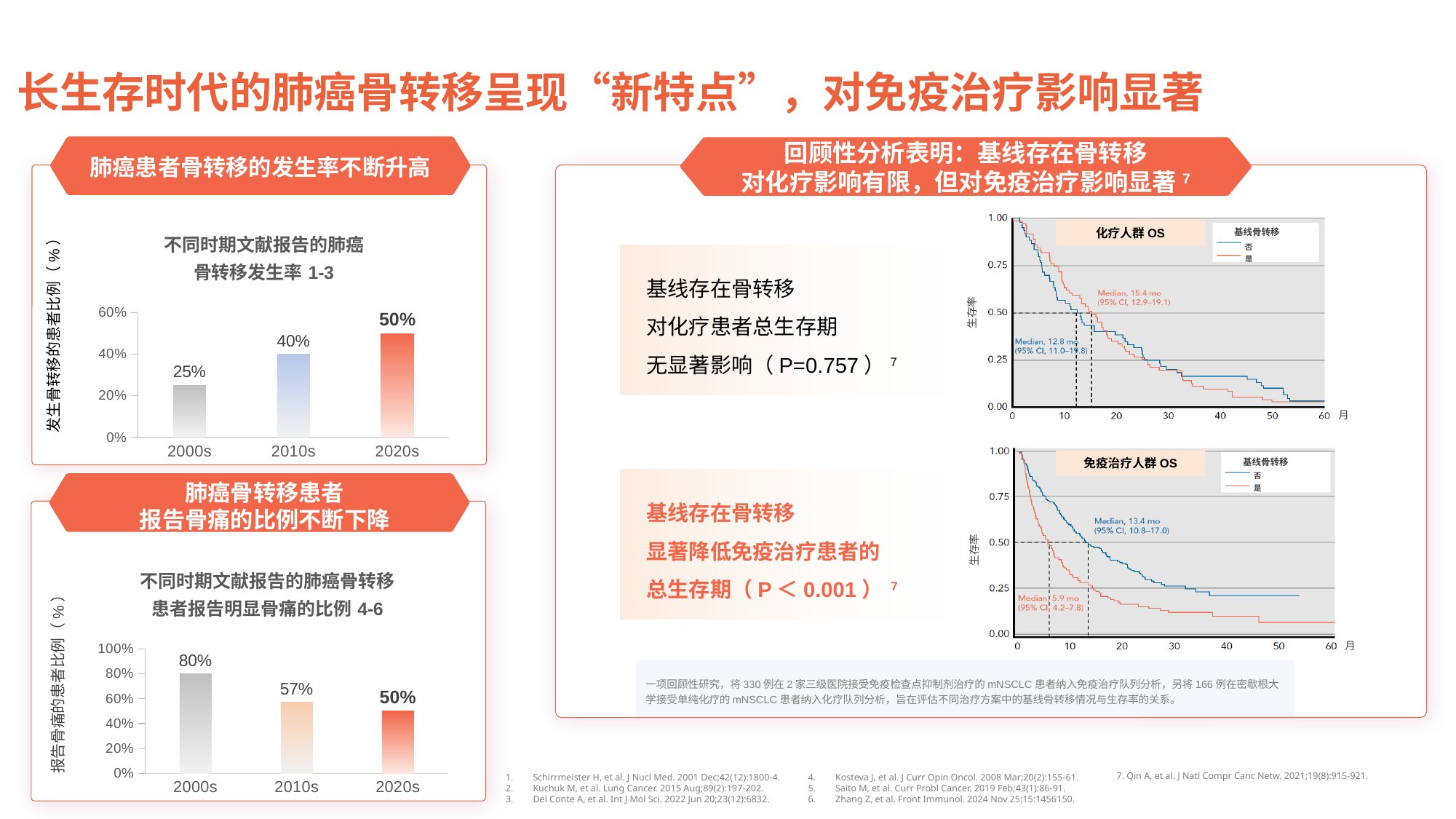
In the bottom-left bar chart (患者报告明显骨痛的比例), what is the value for 2010s? 57% What kind of chart is the bottom-left chart (患者报告明显骨痛的比例)? bar chart In the top-left bar chart (不同时期文献报告的肺癌骨转移发生率), what is the value for 2010s? 40% In the 化疗人群 OS curve chart, what is the median survival for the group with baseline bone metastasis (是)? 15.4 mo In the top-left bar chart (不同时期文献报告的肺癌骨转移发生率), what is the difference between the 2020s and 2000s values? 25% In the bottom-left bar chart (患者报告明显骨痛的比例), which period has the lowest value? 2020s In the top-left bar chart (不同时期文献报告的肺癌骨转移发生率), do the values rise or fall from 2000s to 2020s? rise In the 免疫治疗人群 OS curve chart, what is the median survival for the group with baseline bone metastasis (是)? 5.9 mo In the bottom-left bar chart (患者报告明显骨痛的比例), how many periods are shown on the x axis? 3 In the 免疫治疗人群 OS curve chart, how many series does the legend list? 2 In the bottom-left bar chart (患者报告明显骨痛的比例), what is the difference between the 2000s and 2020s values? 30% In the top-left bar chart (不同时期文献报告的肺癌骨转移发生率), which period has the highest value? 2020s